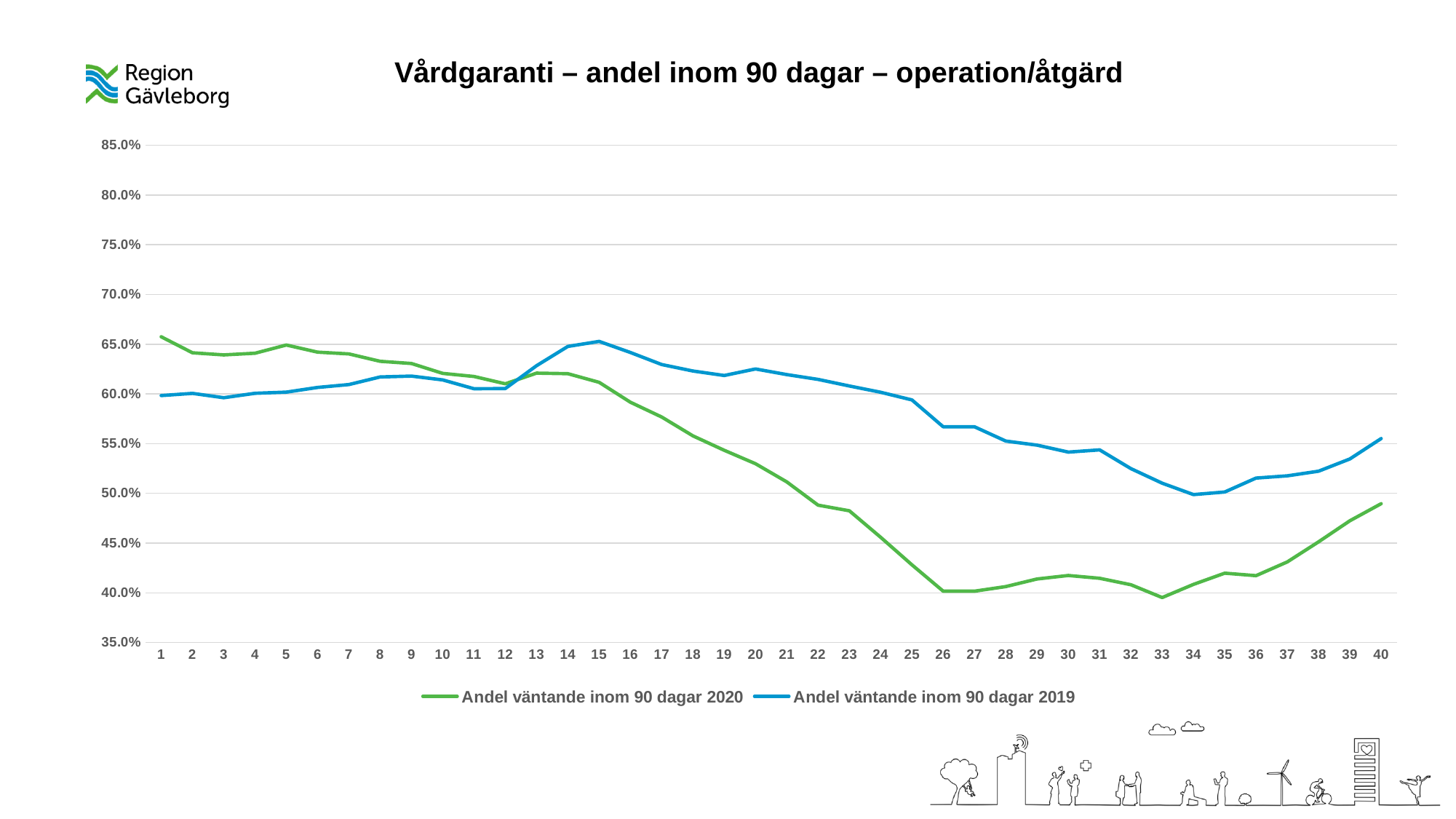
How many series does the legend list? 2 Is the value for 'Andel väntande inom 90 dagar 2019' at point 15 greater or less than 60.0%? greater What kind of chart is shown on the slide? line chart Does the series 'Andel väntande inom 90 dagar 2019' rise or fall between point 34 and point 40? rise Is the value for 'Andel väntande inom 90 dagar 2020' at point 33 greater or less than 45.0%? less At point 5, which series has the larger value, 'Andel väntande inom 90 dagar 2020' or 'Andel väntande inom 90 dagar 2019'? Andel väntande inom 90 dagar 2020 Which colour is used for the series 'Andel väntande inom 90 dagar 2019'? blue Does the series 'Andel väntande inom 90 dagar 2020' rise or fall between point 15 and point 26? fall What is the title of the chart? Vårdgaranti – andel inom 90 dagar – operation/åtgärd How many points are plotted along the x axis for each series? 40 Is the value for 'Andel väntande inom 90 dagar 2019' at point 34 greater or less than 55.0%? less At point 30, which series has the larger value, 'Andel väntande inom 90 dagar 2020' or 'Andel väntande inom 90 dagar 2019'? Andel väntande inom 90 dagar 2019